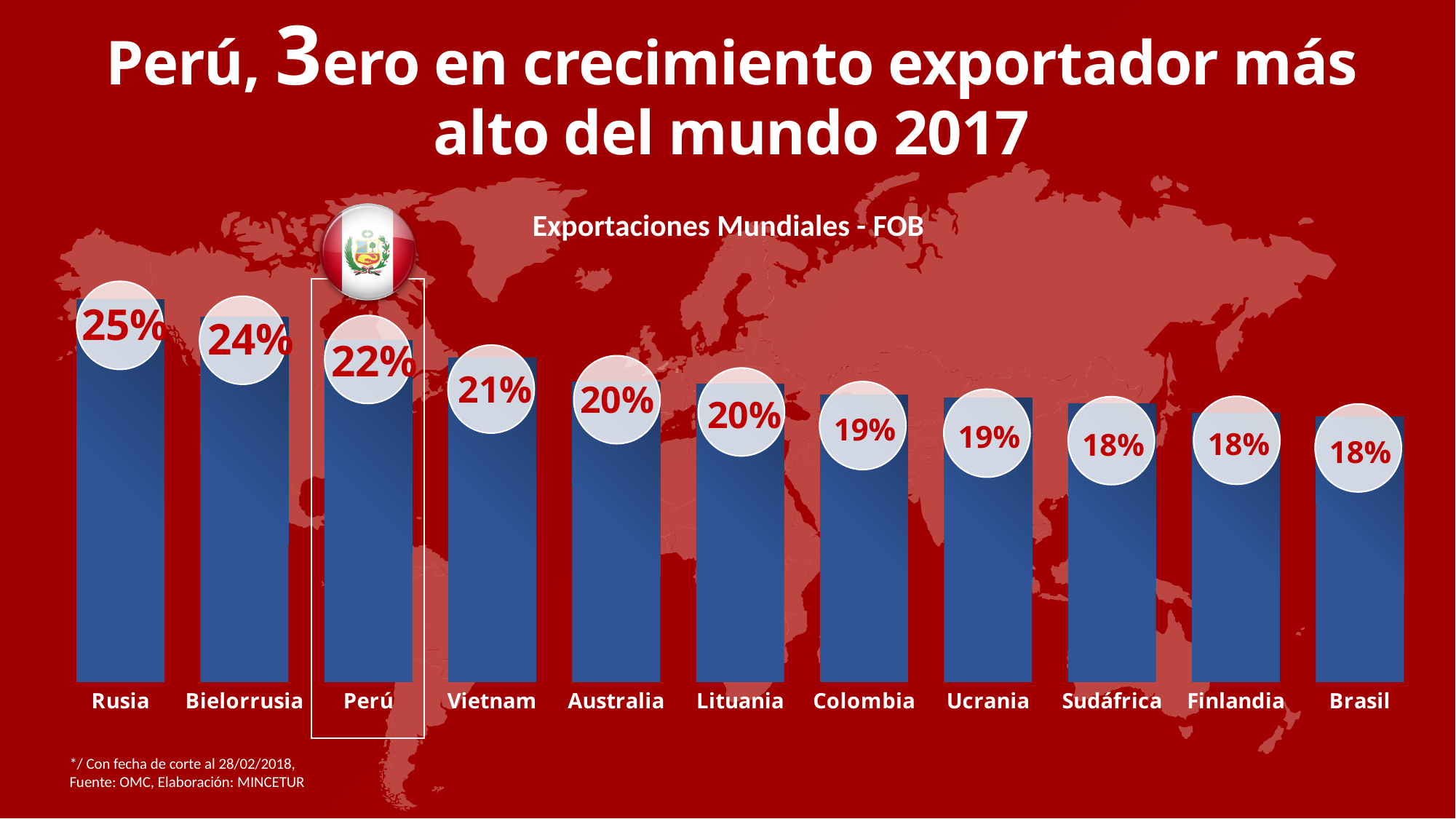
Which is larger, the value for Australia or the value for Sudáfrica? Australia How many countries are shown in the chart? 11 Which country has the highest value? Rusia What is the difference between the values for Rusia and Perú? 3% What is the value for Perú? 22% Do the values rise or fall from left to right across the chart? Fall What is the difference between the values for Bielorrusia and Brasil? 6% What is the value for Vietnam? 21% What is the value for Colombia? 19% What kind of chart is shown on the slide? Bar chart What is the subtitle shown above the chart? Exportaciones Mundiales - FOB Which is larger, the value for Bielorrusia or the value for Ucrania? Bielorrusia